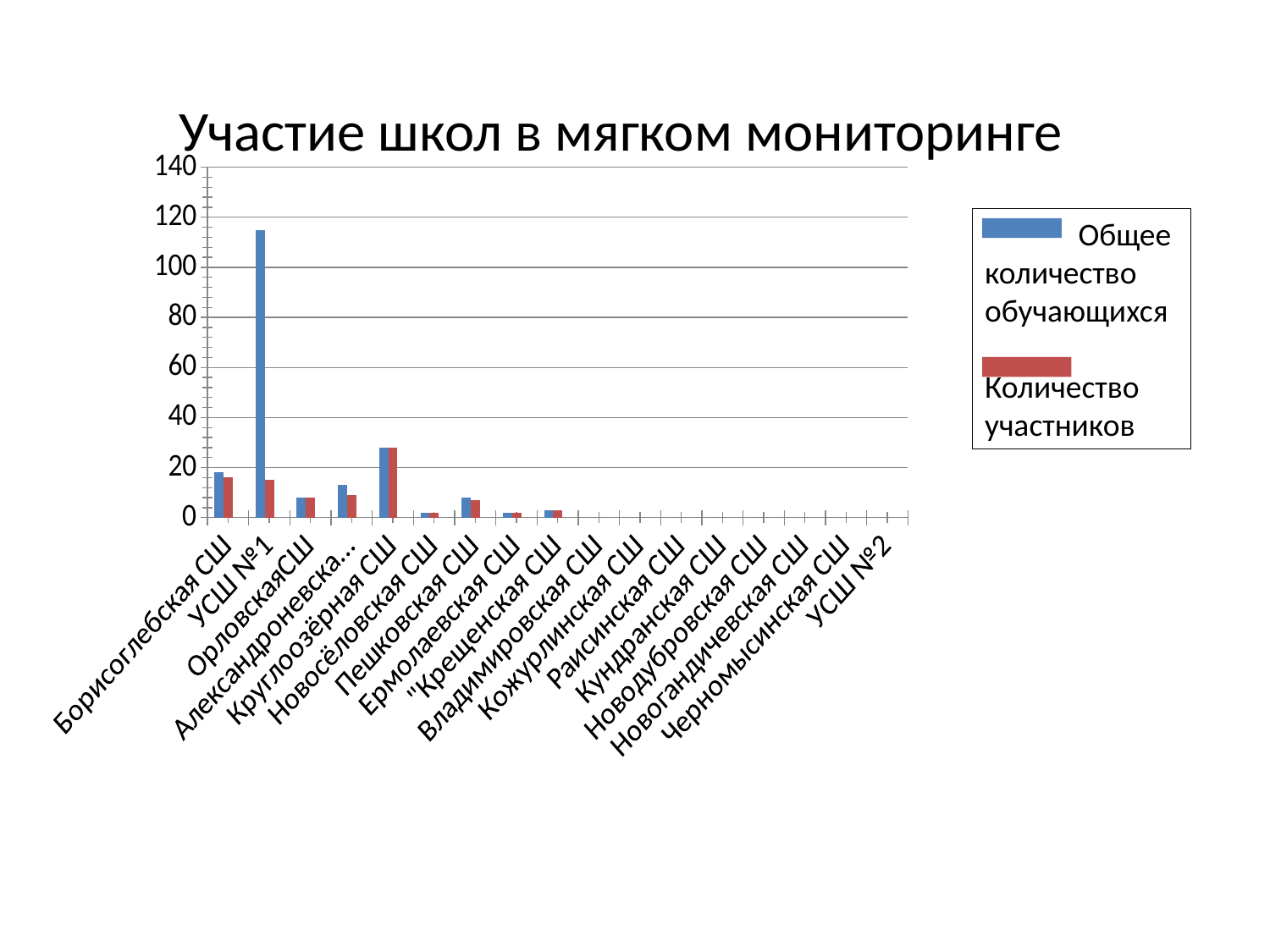
Is the value of "Общее количество обучающихся" for УСШ №1 greater or less than 100? greater How many series does the legend list? 2 How many schools (categories) are shown on the x axis? 17 Which school has the highest value for "Общее количество обучающихся"? УСШ №1 Is the value of "Общее количество обучающихся" for Круглоозёрная СШ greater or less than 20? greater Which school has the highest value for "Количество участников"? Круглоозёрная СШ What kind of chart is shown on the slide? bar chart Is the value of "Количество участников" for УСШ №1 greater or less than 20? less For УСШ №1, which is larger: "Общее количество обучающихся" or "Количество участников"? Общее количество обучающихся What is the title of the chart? Участие школ в мягком мониторинге Which school has the larger value for "Общее количество обучающихся": Борисоглебская СШ or Круглоозёрная СШ? Круглоозёрная СШ Which colour represents the series "Количество участников" in the legend? red